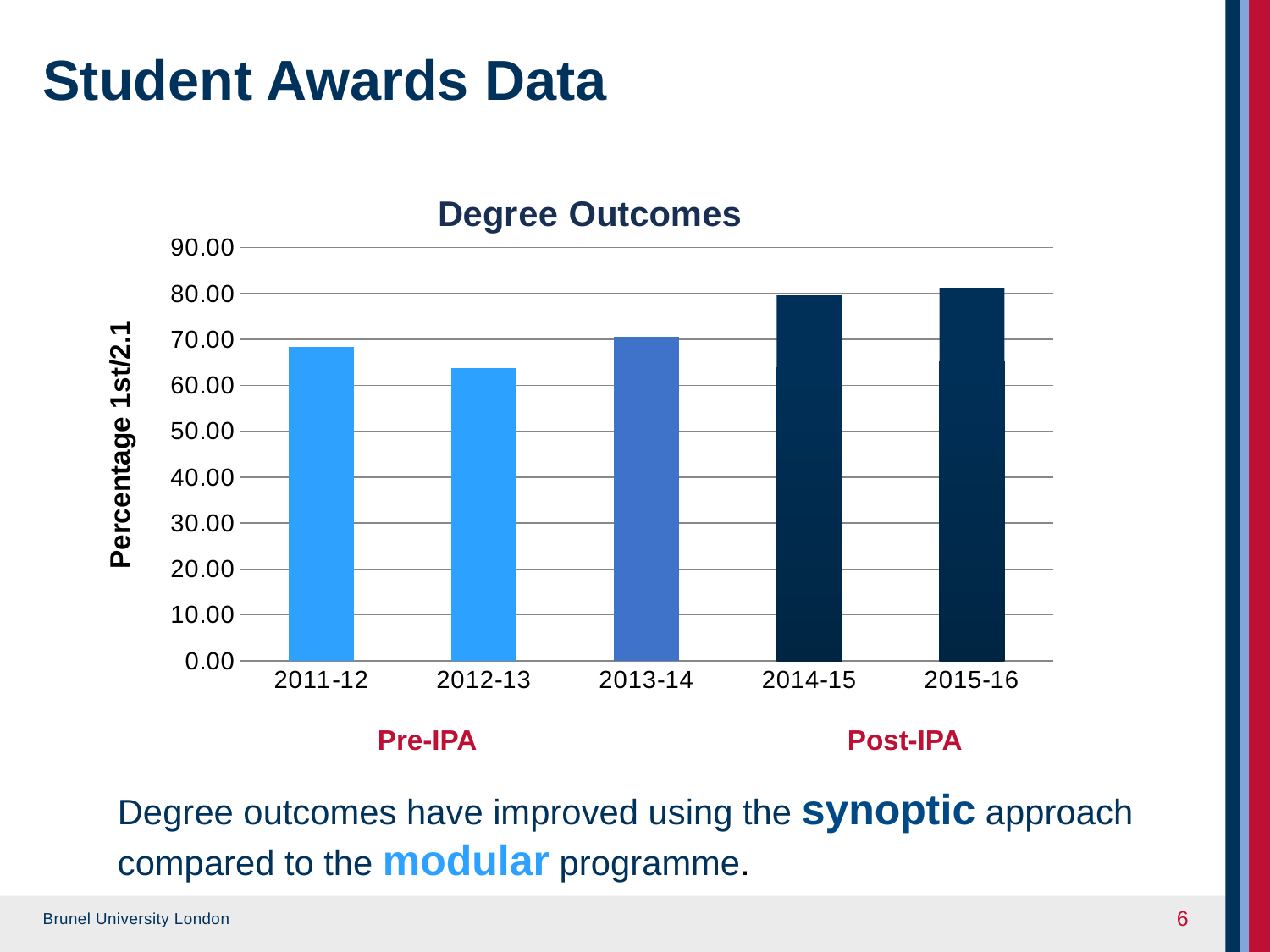
Is the value for 2012-13 greater or less than 70? less Is the value for 2013-14 greater or less than 60? greater Is the value for 2015-16 greater or less than 80? greater What is the label on the vertical axis of the chart? Percentage 1st/2.1 What is the title of the chart? Degree Outcomes How many academic years are plotted in the Degree Outcomes chart? 5 What type of chart is shown on the slide? bar chart Do the values generally rise or fall from 2011-12 to 2015-16? rise Which is larger, the value for 2014-15 or the value for 2012-13? 2014-15 Which academic year has the lowest percentage of 1st/2.1 degrees? 2012-13